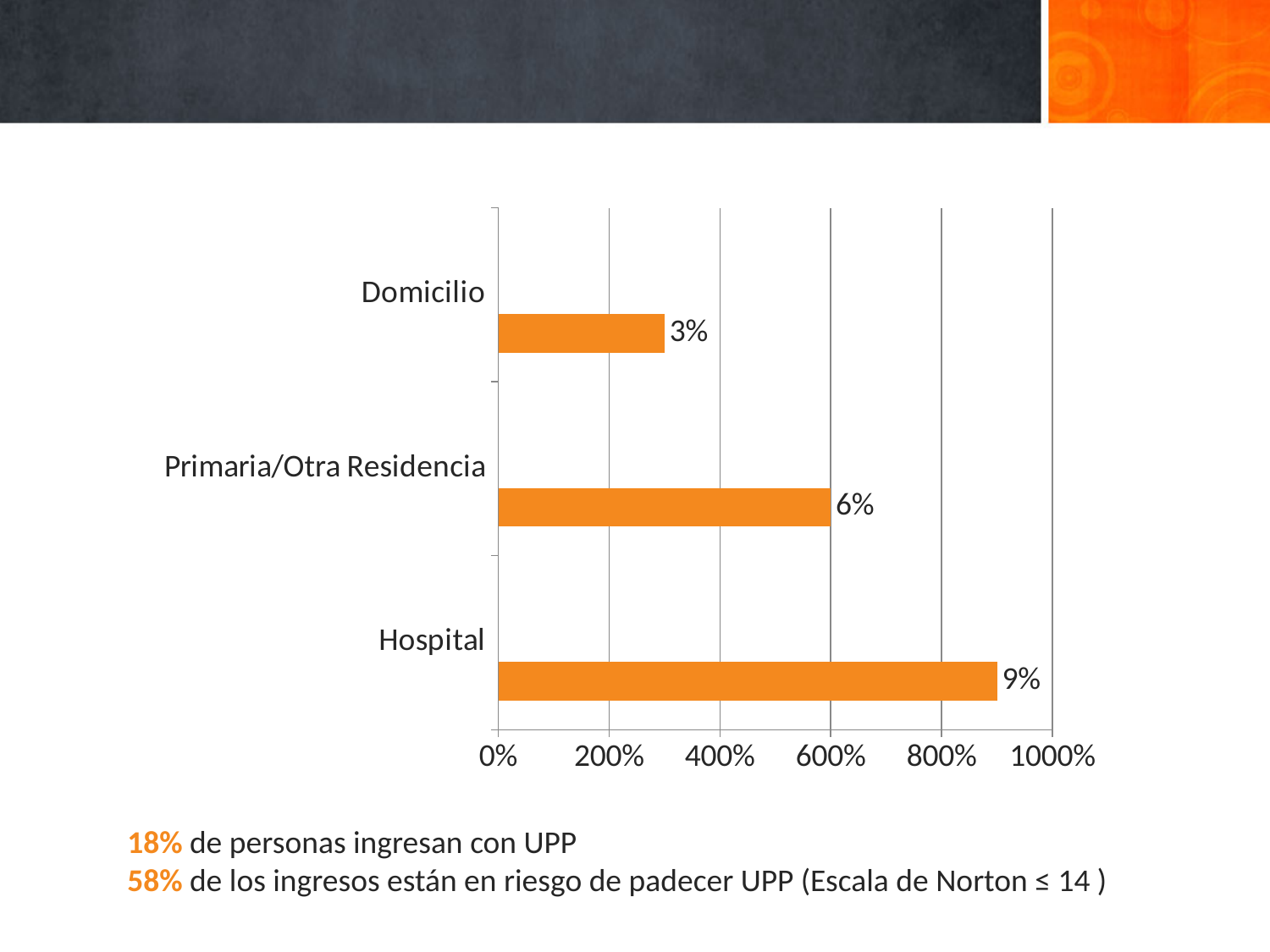
What is the difference between the values for Hospital and Domicilio? 6% How many categories are shown in the chart? 3 What is the value for Domicilio? 3% What kind of chart is shown on the slide? Bar chart What colour are the bars in the chart? Orange Which category has the highest value? Hospital What is the value for Primaria/Otra Residencia? 6% What is the value for Hospital? 9% What is the highest tick label shown on the horizontal axis? 1000% What is the difference between the values for Primaria/Otra Residencia and Domicilio? 3% Which is larger, the value for Hospital or the value for Primaria/Otra Residencia? Hospital Which category has the lowest value? Domicilio